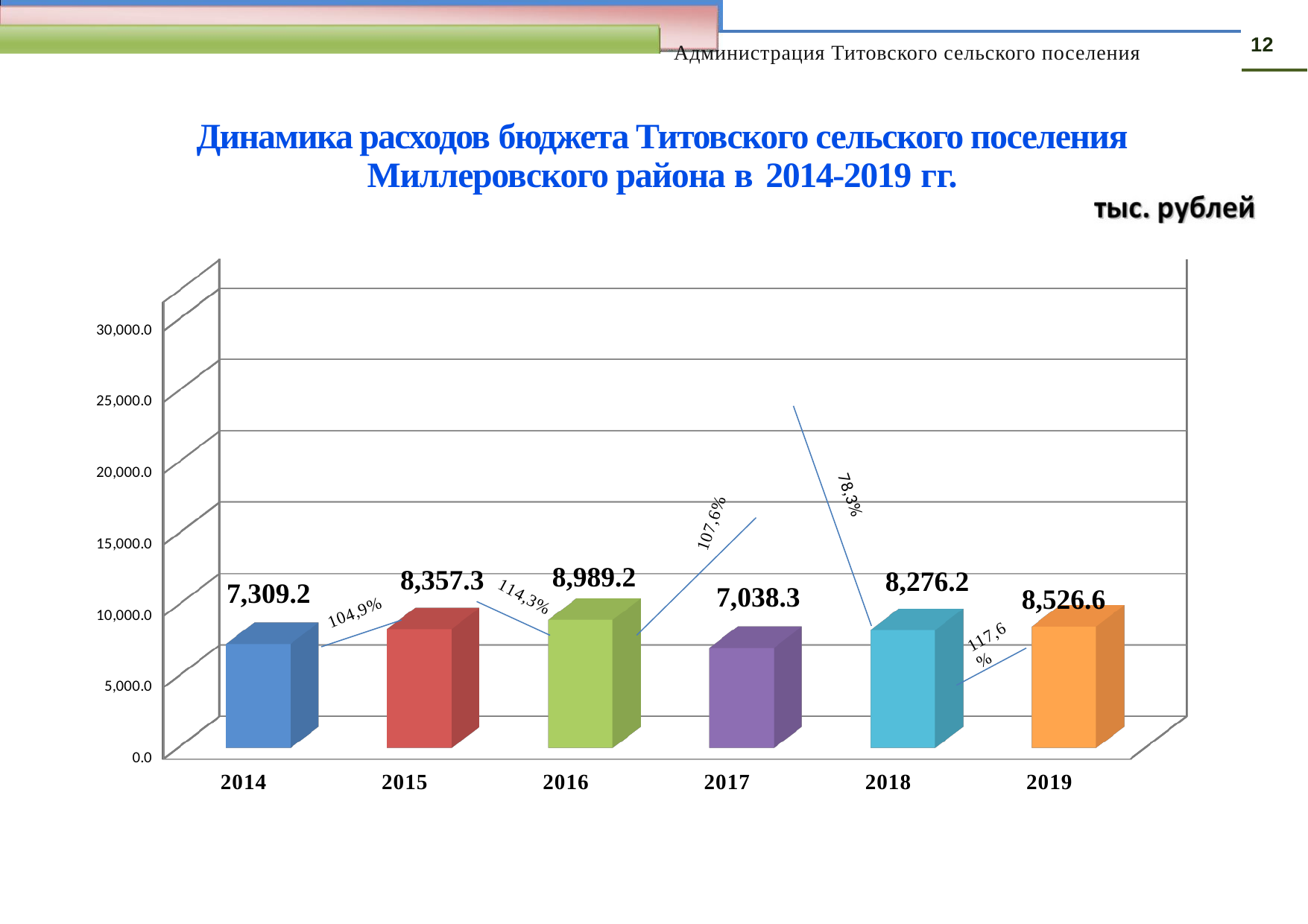
What kind of chart is shown on the slide? bar chart What is the value shown for 2019? 8,526.6 Is the value for 2014 greater or less than 10,000.0? less Did the value rise or fall from 2016 to 2017? fall Which is larger, the value for 2015 or the value for 2018? 2015 What is the value shown for 2017? 7,038.3 How many years are shown on the x axis of the chart? 6 What is the budget expenditure value shown for 2014? 7,309.2 Which year has the highest value on the chart? 2016 Which year has the lowest value on the chart? 2017 What is the difference between the values for 2019 and 2017? 1,488.3 What is the difference between the values for 2016 and 2014? 1,680.0